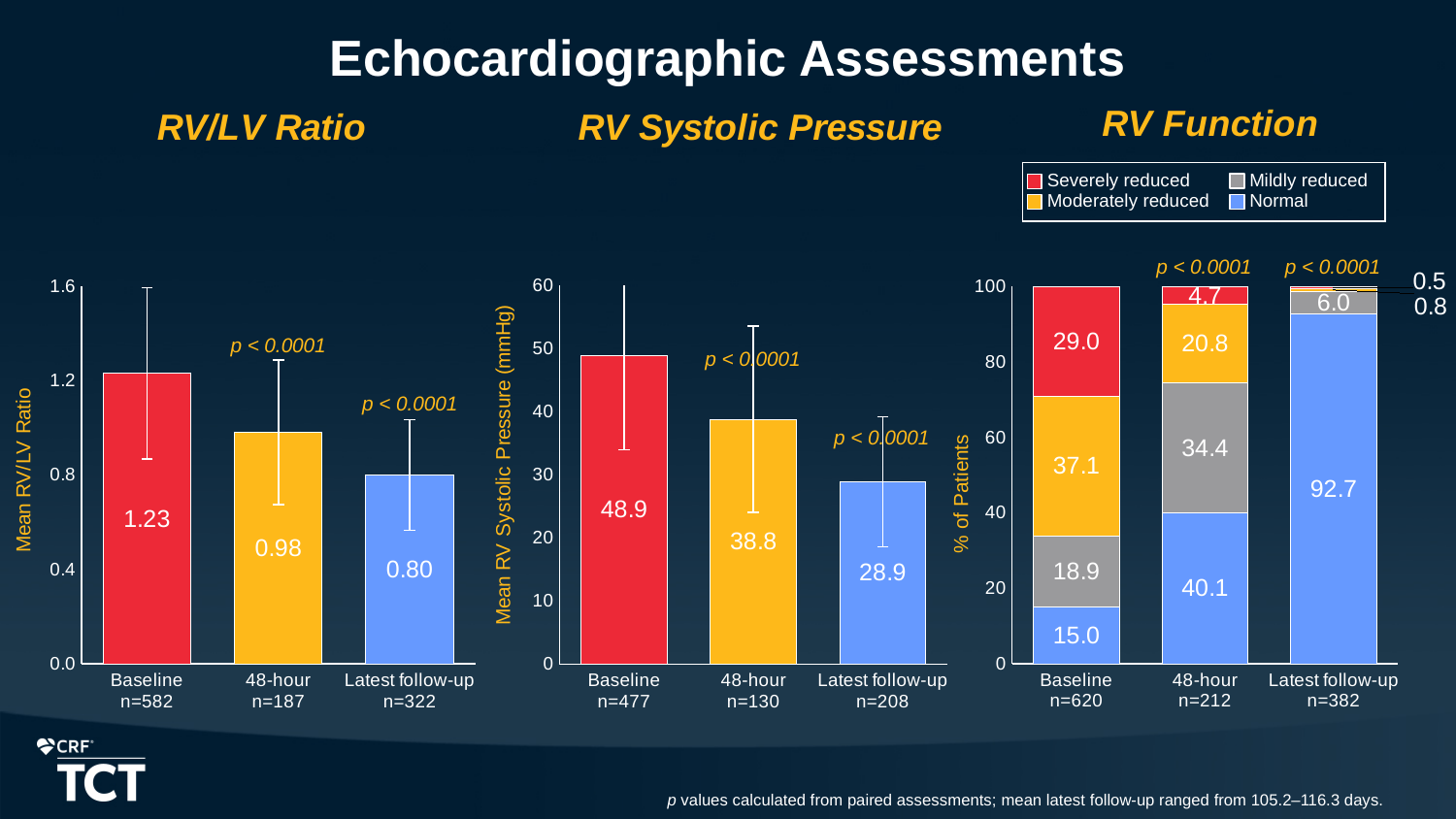
In the RV Systolic Pressure chart, which time point has the lowest value? Latest follow-up In the RV Function chart, what percentage of patients had normal RV function at latest follow-up? 92.7 In the RV Function chart, what percentage of patients had severely reduced RV function at baseline? 29.0 In the RV Systolic Pressure chart, what is the mean RV systolic pressure at 48 hours? 38.8 In the RV Function chart, which is larger at 48 hours: the mildly reduced share or the moderately reduced share? Mildly reduced In the RV Systolic Pressure chart, what is the difference between the baseline and latest follow-up values? 20.0 In the RV Function chart, how many series does the legend list? 4 In the RV/LV Ratio chart, what is the mean RV/LV ratio at baseline? 1.23 What type of chart is the RV Function chart? Stacked bar chart In the RV/LV Ratio chart, do the values rise or fall from baseline to latest follow-up? fall In the RV/LV Ratio chart, what is the difference between the baseline and 48-hour values? 0.25 In the RV/LV Ratio chart, what is the value at latest follow-up? 0.80